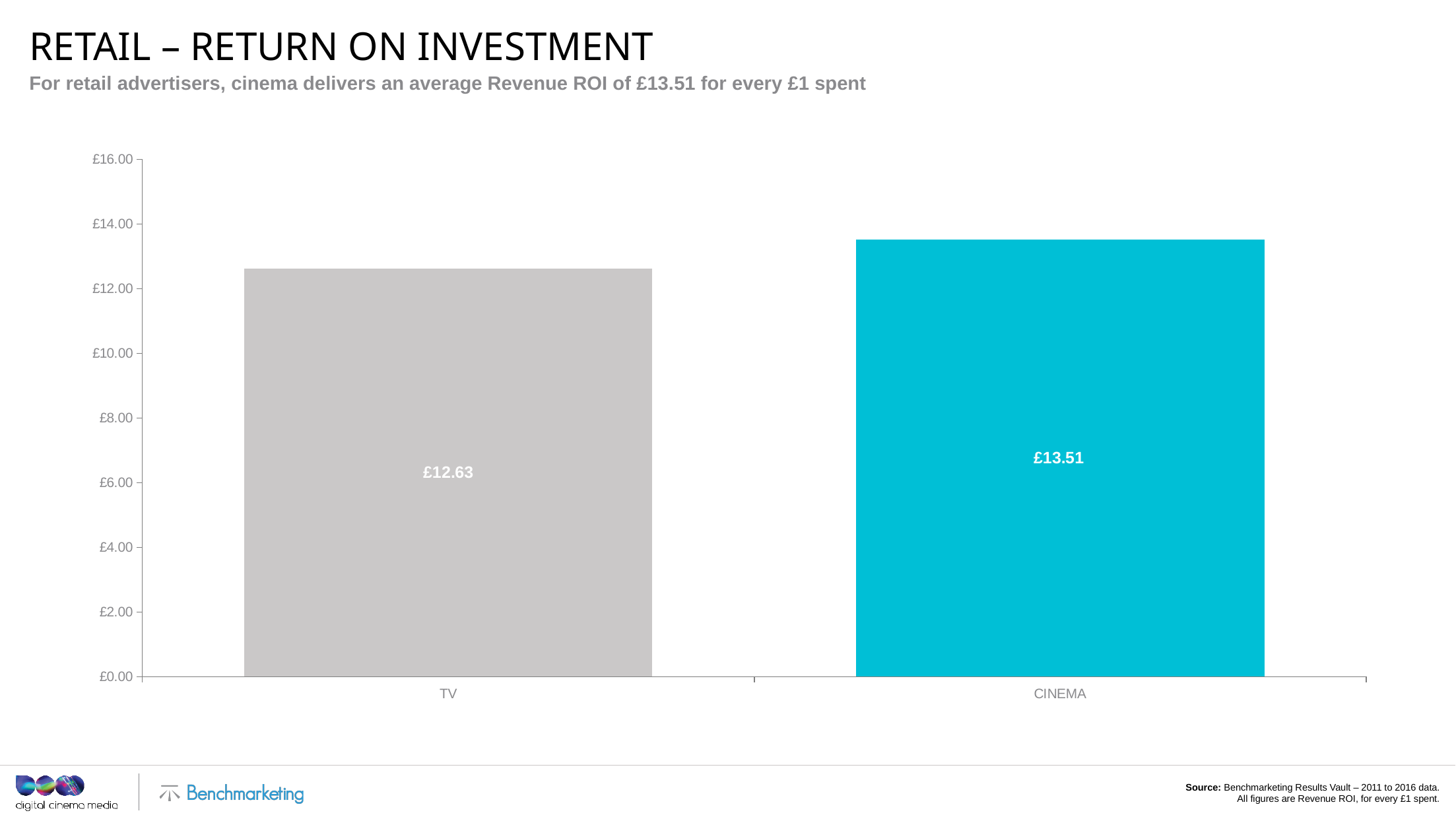
What is the difference between the CINEMA and TV Revenue ROI values? £0.88 Which category has the lowest Revenue ROI? TV What is the Revenue ROI value shown for TV? £12.63 Is the value for TV greater or less than £12.00? greater Is the value for CINEMA greater or less than £14.00? less What is the Revenue ROI value shown for CINEMA? £13.51 What is the title of the slide? RETAIL – RETURN ON INVESTMENT How many categories are shown on the chart? 2 Which is larger, the value for TV or the value for CINEMA? CINEMA What colour is the CINEMA bar? Blue (cyan) Which category has the highest Revenue ROI? CINEMA What kind of chart is shown on the slide? bar chart